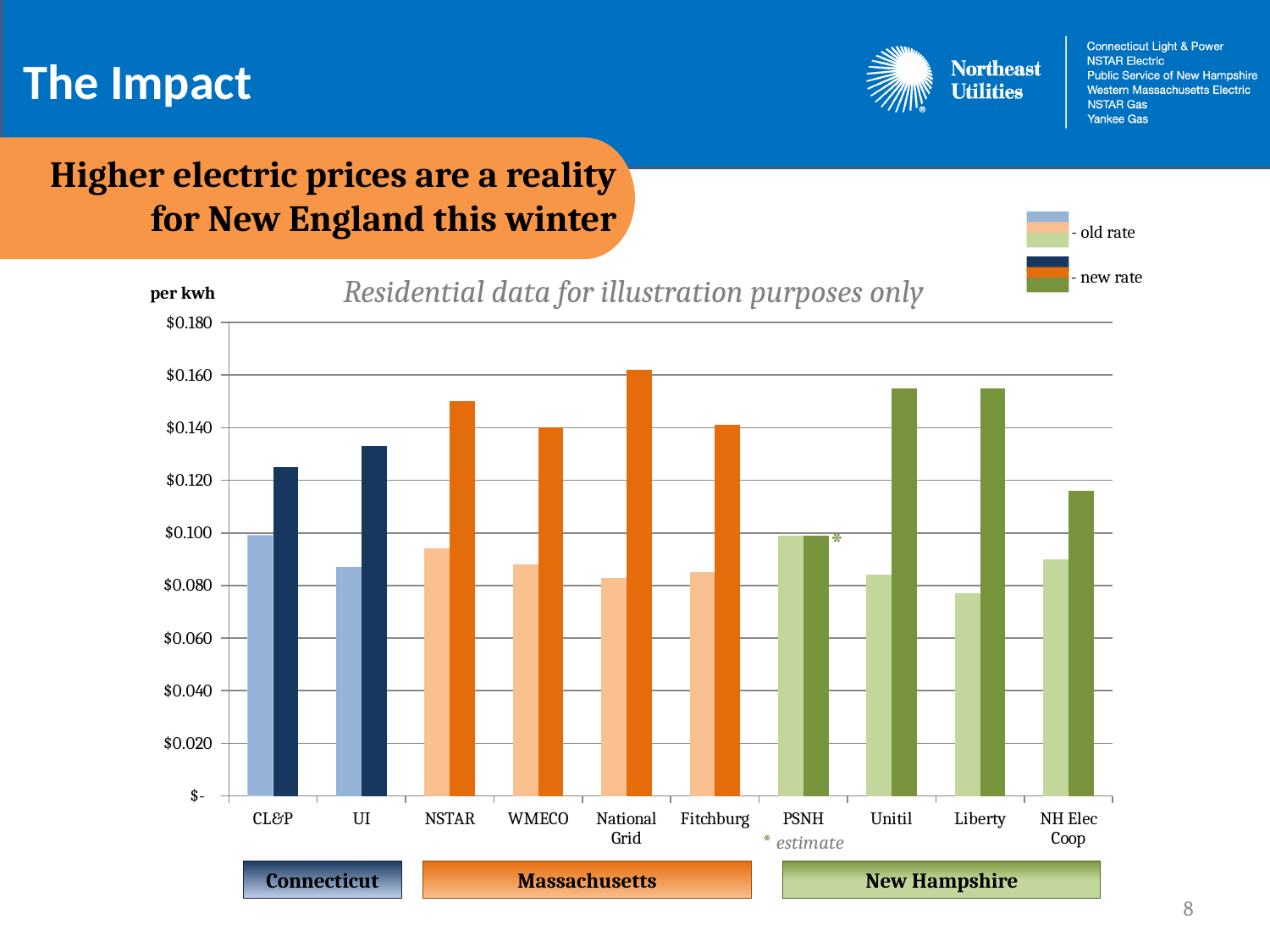
Which utility has the lowest old rate in the chart? Liberty Which is larger, the new rate for NSTAR or the new rate for WMECO? NSTAR How many series does the chart legend list? 2 Is the old rate for UI greater or less than $0.100? less Which utility's values are marked with an asterisk as an estimate? PSNH How many utilities (categories) are shown along the x axis of the chart? 10 Which utility has the lowest new rate in the chart? PSNH Which utility has the highest new rate in the chart? National Grid Is the new rate for National Grid greater or less than $0.140? greater Which is larger, the new rate for CL&P or the new rate for UI? UI Is the new rate for NH Elec Coop greater or less than $0.100? greater What kind of chart is shown on the slide? bar chart